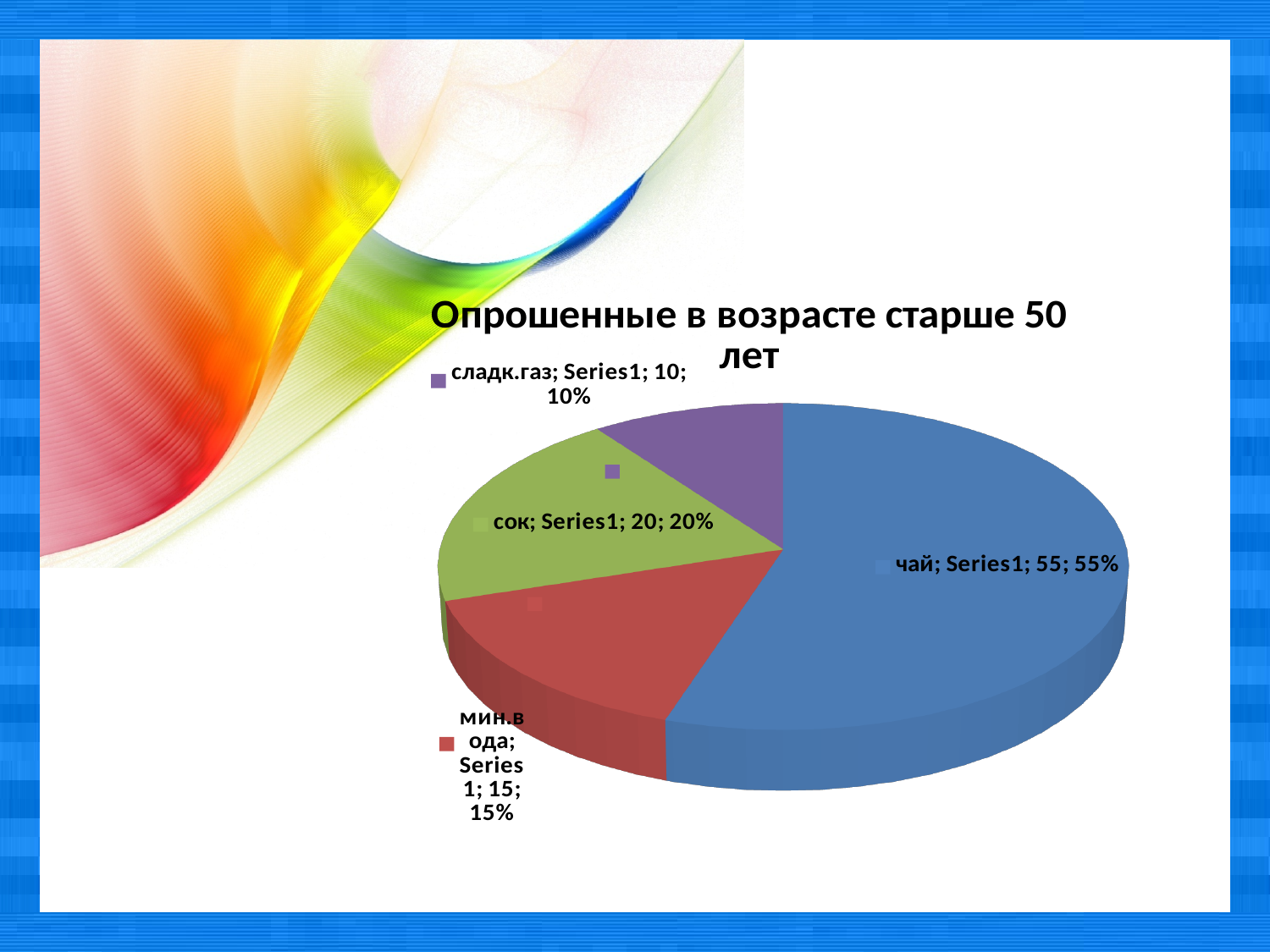
How many categories are shown in the pie chart? 4 What share of the pie does сок represent? 20% Which is larger, the value for мин.вода or the value for сладк.газ? мин.вода What is the title of the chart? Опрошенные в возрасте старше 50 лет What is the value for сладк.газ? 10 What is the value for сок? 20 Which category has the largest slice? чай What kind of chart is shown on the slide? pie chart What is the value for чай? 55 What is the value for мин.вода? 15 What is the difference between the values for чай and сок? 35 Which category has the smallest slice? сладк.газ